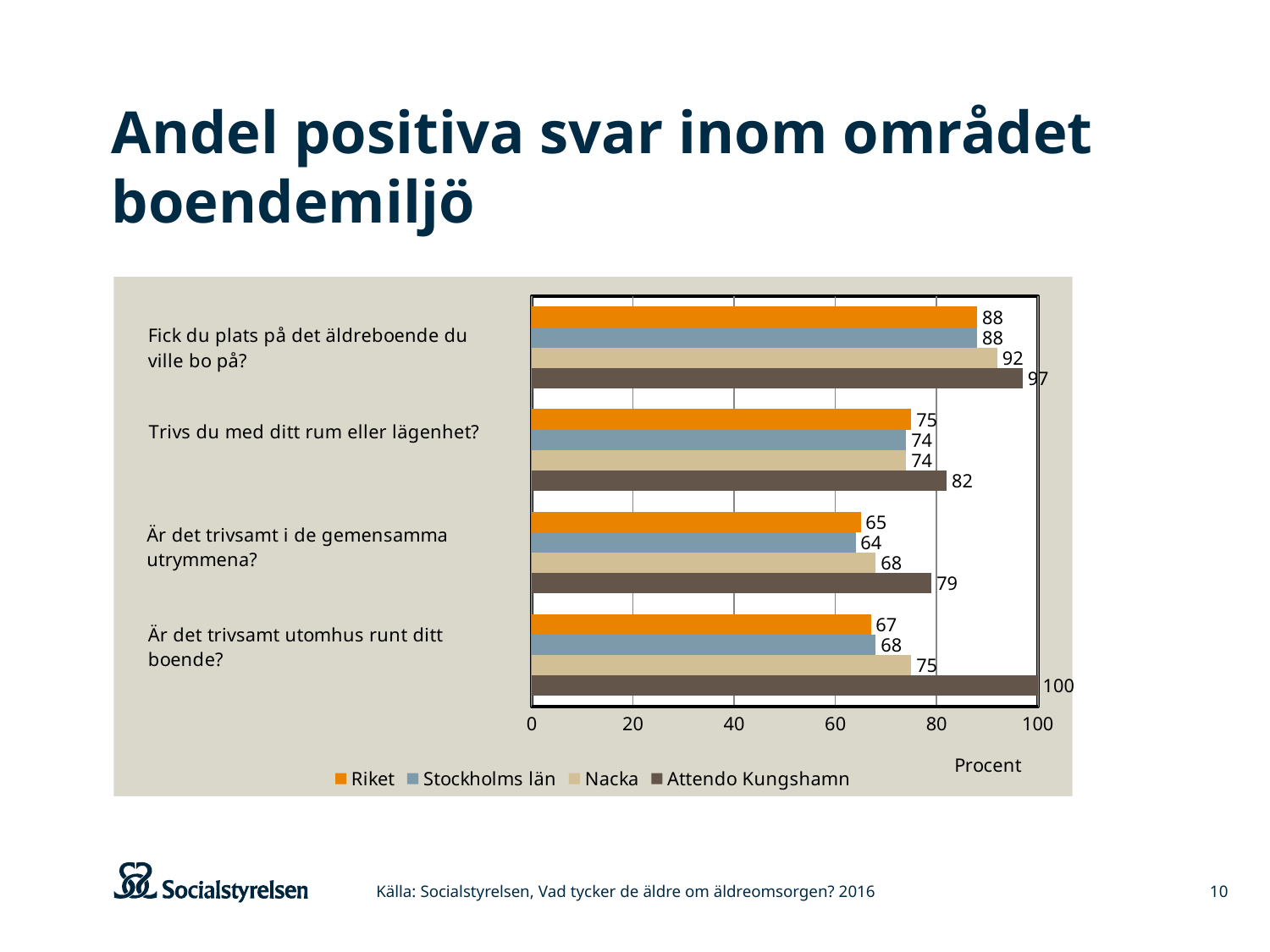
Which is larger for "Är det trivsamt utomhus runt ditt boende?": Nacka or Stockholms län? Nacka How many series does the legend list? 4 What kind of chart is shown on the slide? Bar chart What is the label of the horizontal axis? Procent Which series has the lowest value for "Är det trivsamt utomhus runt ditt boende?"? Riket What is the value for Attendo Kungshamn for "Är det trivsamt utomhus runt ditt boende?"? 100 What is the value for Stockholms län for "Är det trivsamt i de gemensamma utrymmena?"? 64 What is the difference between Attendo Kungshamn and Riket for "Trivs du med ditt rum eller lägenhet?"? 7 Which series has the highest value for "Är det trivsamt i de gemensamma utrymmena?"? Attendo Kungshamn What is the value for Nacka for "Fick du plats på det äldreboende du ville bo på?"? 92 What is the value for Riket for "Trivs du med ditt rum eller lägenhet?"? 75 How many question categories are shown on the chart? 4